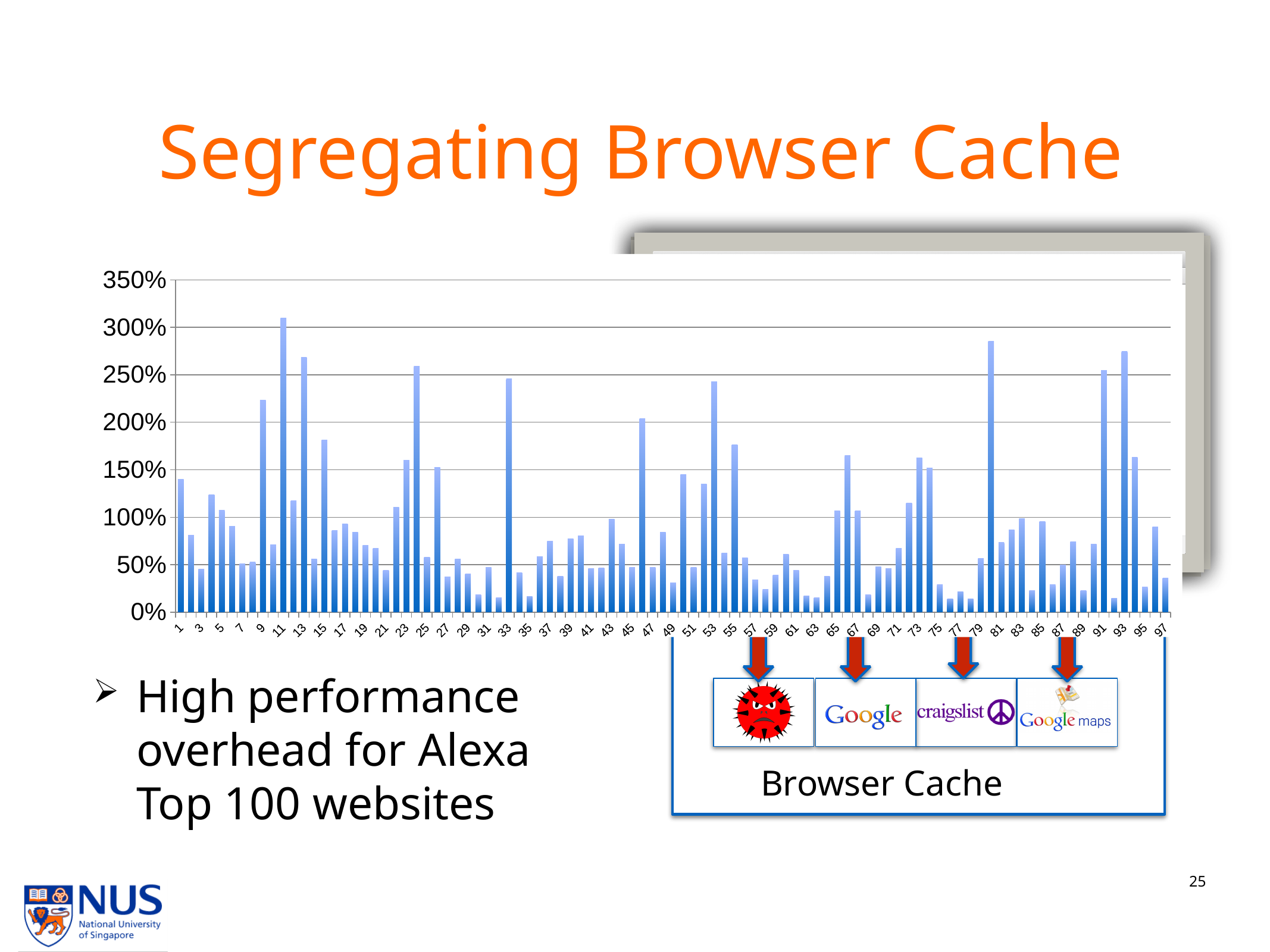
Is the value for category 81 greater or less than 250%? less Is the value for category 1 greater or less than 100%? greater Which is larger, the value for category 33 or the value for category 35? 33 Is the value for category 55 greater or less than 150%? greater Which category has the highest bar in the chart? 11 Which is larger, the value for category 11 or the value for category 13? 11 What is the highest value shown on the chart's vertical axis? 350% What kind of chart is shown on the slide? bar chart